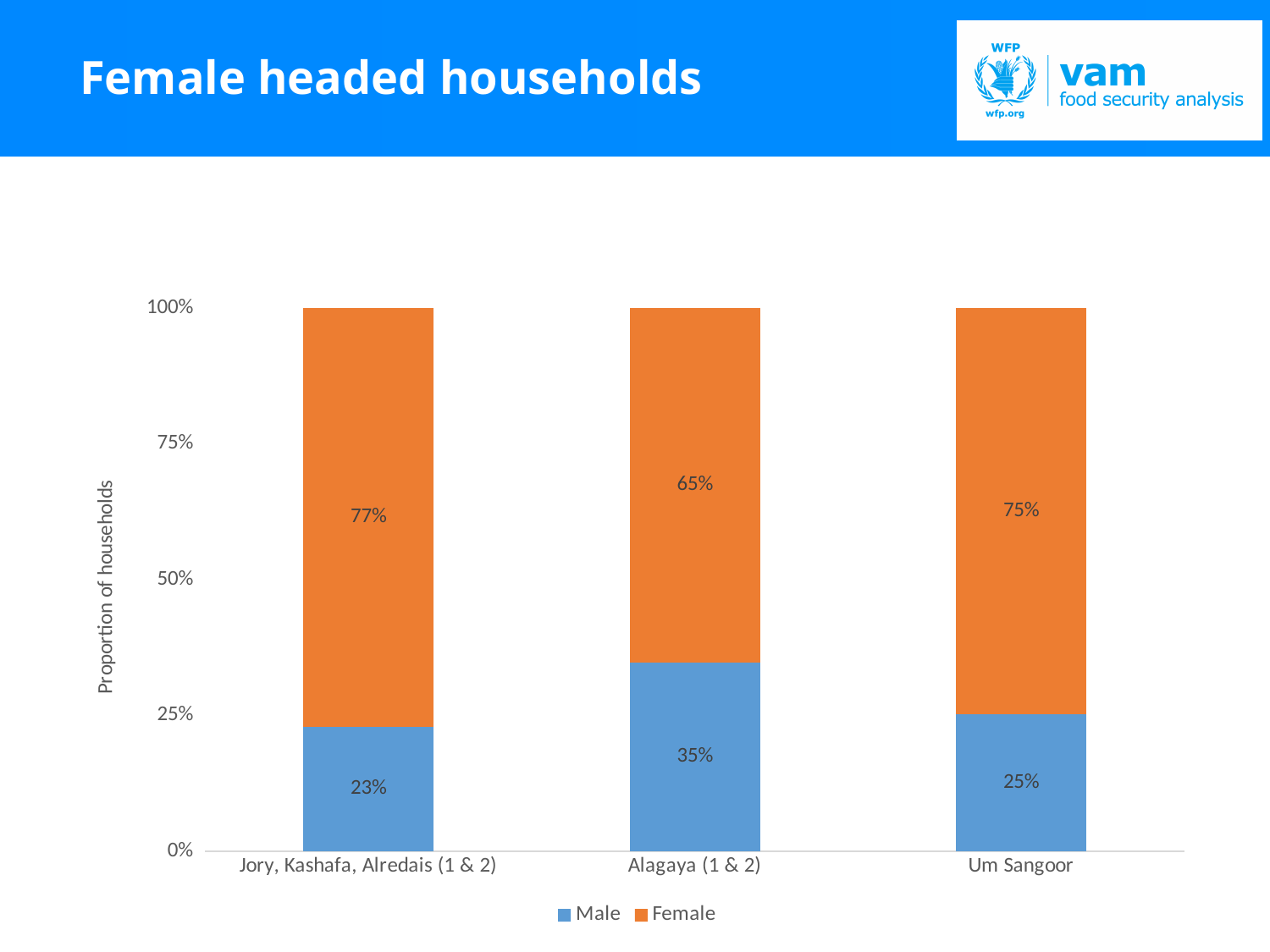
What kind of chart is shown on the slide? Stacked bar chart What is the Male value for Alagaya (1 & 2)? 35% Which is larger: the Male value for Alagaya (1 & 2) or the Male value for Um Sangoor? Alagaya (1 & 2) What is the Female value for Um Sangoor? 75% How many series does the legend list? 2 Which category has the lowest Male value? Jory, Kashafa, Alredais (1 & 2) How many categories are shown on the x axis? 3 Which category has the highest Female value? Jory, Kashafa, Alredais (1 & 2) What is the label of the y axis? Proportion of households What is the Female value for Jory, Kashafa, Alredais (1 & 2)? 77% What is the difference between the Female and Male values for Alagaya (1 & 2)? 30% What is the Male value for Um Sangoor? 25%